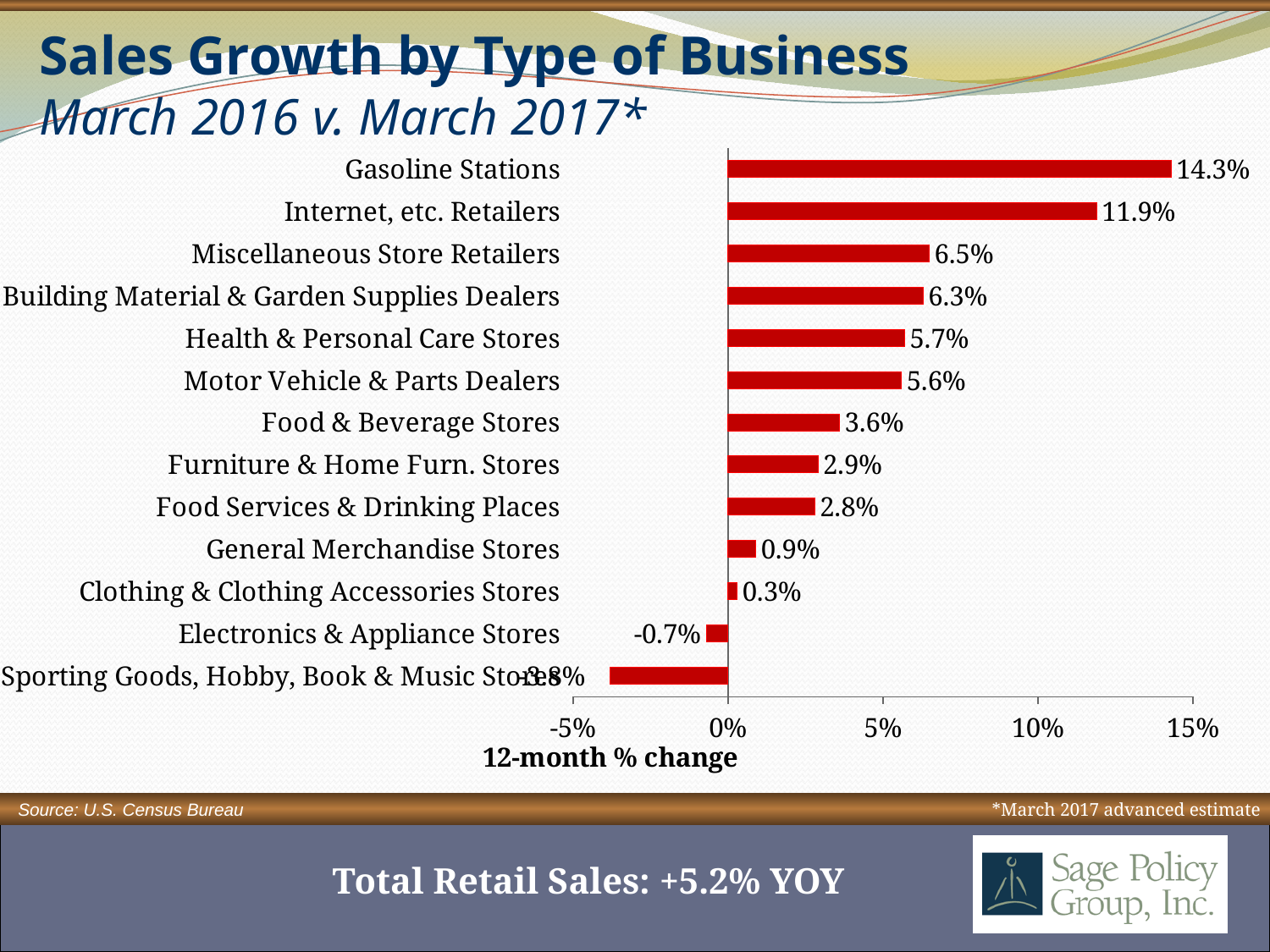
What is the 12-month % change for Food & Beverage Stores? 3.6% What is the 12-month % change for Electronics & Appliance Stores? -0.7% What kind of chart is shown on the slide? Bar chart How many types of business are shown in the chart? 13 Which type of business has the highest 12-month % change? Gasoline Stations Which has a larger 12-month % change, Miscellaneous Store Retailers or Food & Beverage Stores? Miscellaneous Store Retailers What is the 12-month % change for Internet, etc. Retailers? 11.9% Is the value for Building Material & Garden Supplies Dealers greater or less than 5%? greater What is the label of the horizontal axis of the chart? 12-month % change What is the 12-month % change for Gasoline Stations? 14.3% Which type of business has the lowest 12-month % change? Sporting Goods, Hobby, Book & Music Stores What is the difference between the 12-month % change for Gasoline Stations and Internet, etc. Retailers? 2.4%